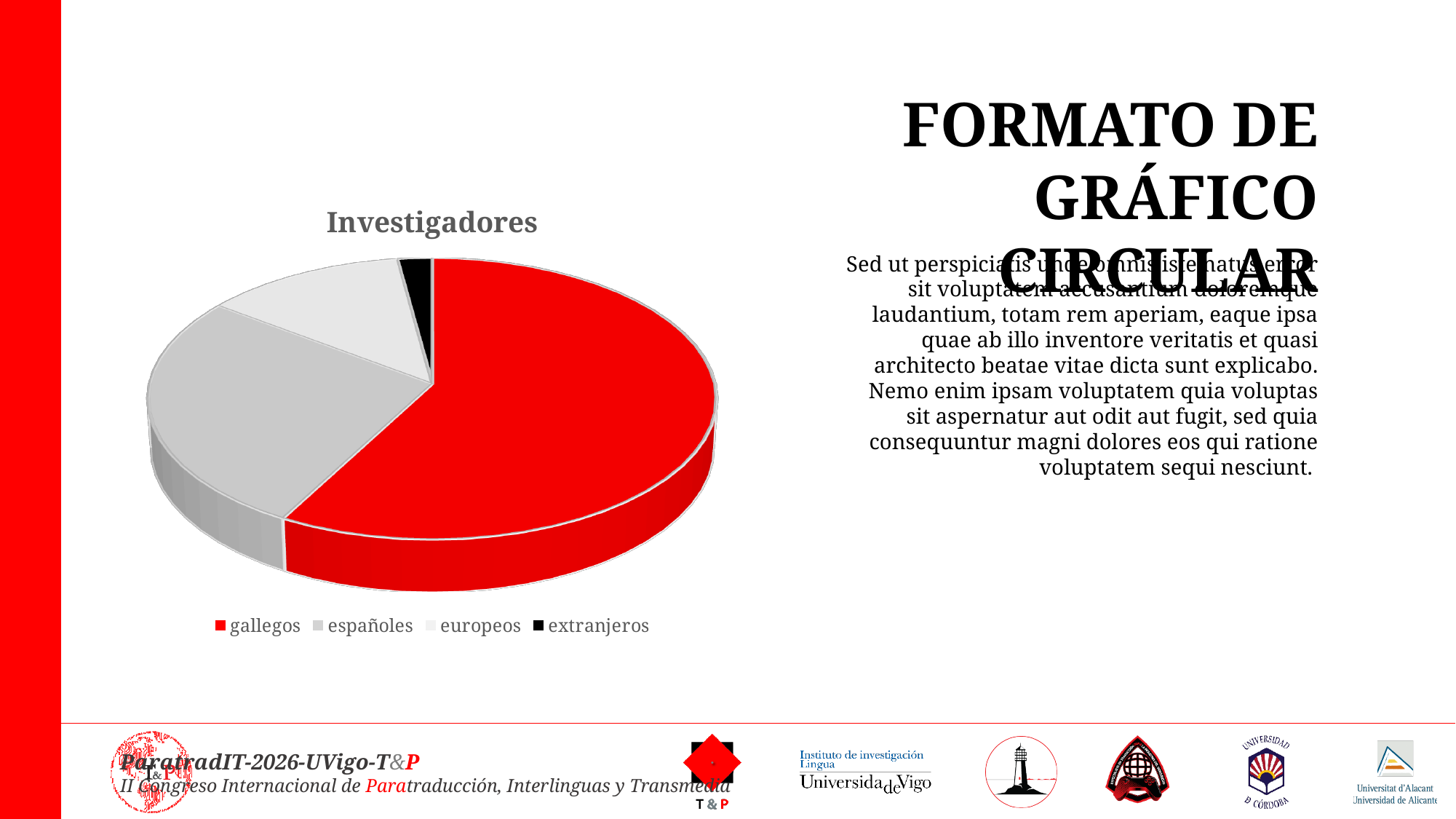
Which category has the largest slice of the pie? gallegos What is the title of the chart? Investigadores Which slice is larger, gallegos or españoles? gallegos How many slices does the pie chart have? 4 What colour is the slice for gallegos? red Which slice is larger, españoles or europeos? españoles What kind of chart is shown on the slide? pie chart Which category has the smallest slice of the pie? extranjeros How many entries does the chart legend list? 4 Does the gallegos slice make up more or less than half of the pie? more Which slice is larger, europeos or extranjeros? europeos